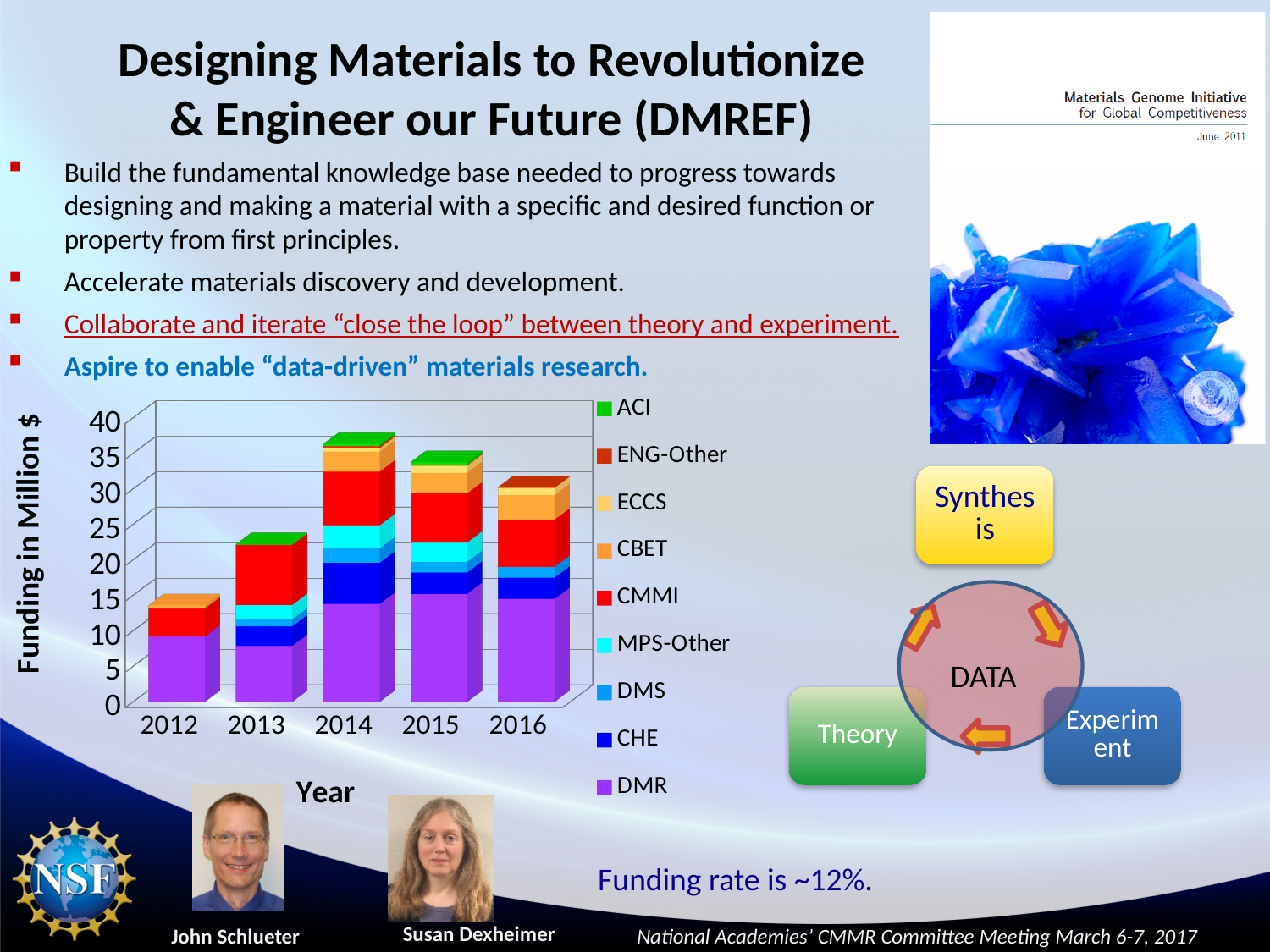
Which year has the lowest total funding in the chart? 2012 Which year has a larger total funding, 2013 or 2015? 2015 What is the title of the y axis of the funding chart? Funding in Million $ Does total funding rise or fall from 2012 to 2014? rise Is the total funding for 2016 greater or less than 25? greater Is the total funding for 2012 greater or less than 20? less What kind of chart is shown on the slide? stacked bar chart Is the total funding for 2014 greater or less than 30? greater How many series does the legend of the funding chart list? 9 Which series is listed at the bottom of the chart's legend? DMR Which year has the highest total funding in the chart? 2014 How many years are shown on the x axis of the funding chart? 5